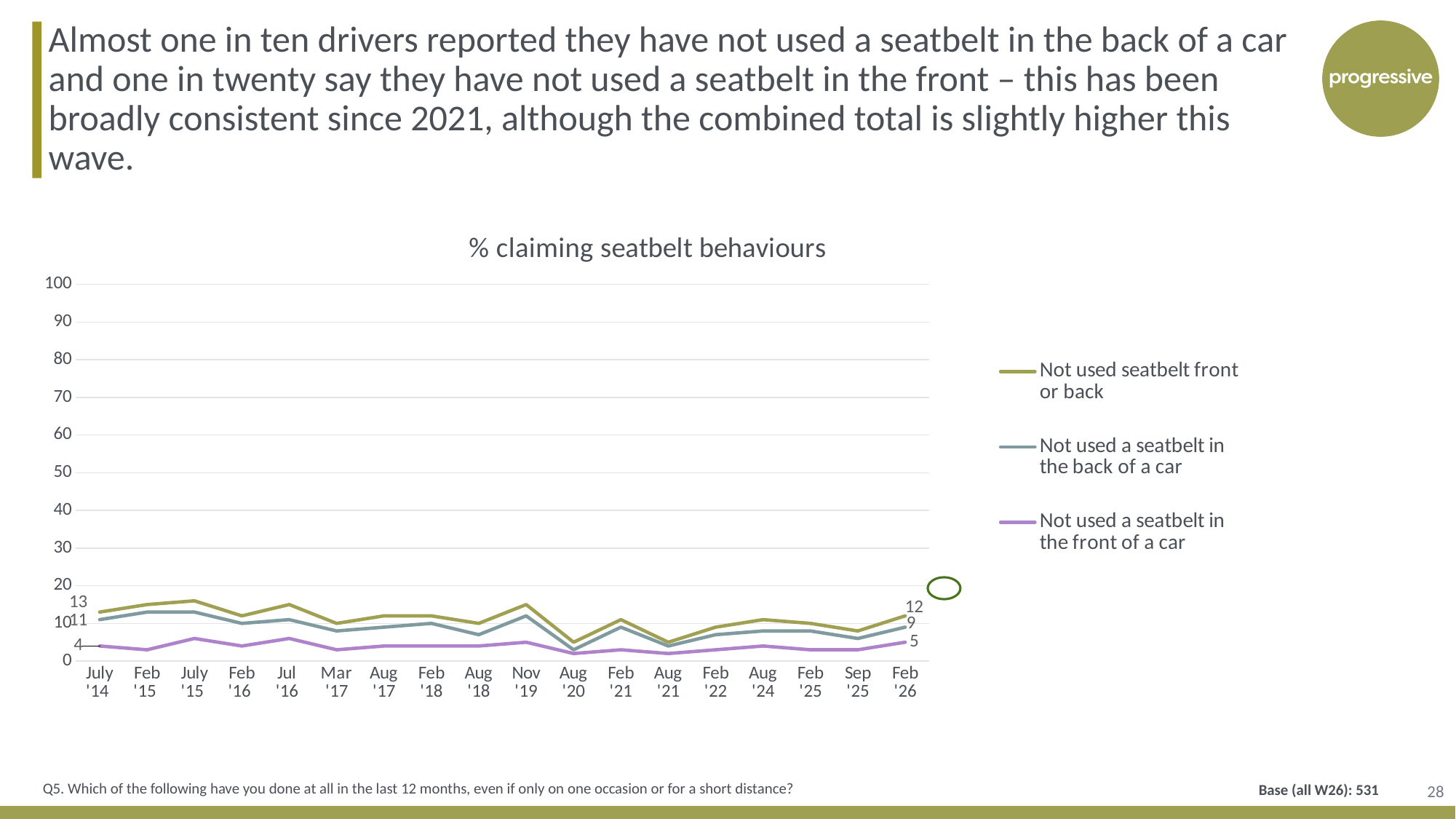
Is the value for 'Not used seatbelt front or back' in July '15 greater or less than 30? less What is the value for 'Not used a seatbelt in the back of a car' in Feb '26? 9 What is the value for 'Not used seatbelt front or back' in Feb '26? 12 How many time points are shown on the x axis? 18 What is the value for 'Not used seatbelt front or back' in July '14? 13 What is the difference between 'Not used seatbelt front or back' in July '14 and in Feb '26? 1 What is the value for 'Not used a seatbelt in the front of a car' in July '14? 4 Which is larger in Feb '26: 'Not used a seatbelt in the back of a car' or 'Not used a seatbelt in the front of a car'? Not used a seatbelt in the back of a car What is the title of the chart? % claiming seatbelt behaviours How many series does the legend list? 3 What type of chart is shown on the slide? line chart What is the difference between 'Not used a seatbelt in the back of a car' and 'Not used a seatbelt in the front of a car' in Feb '26? 4